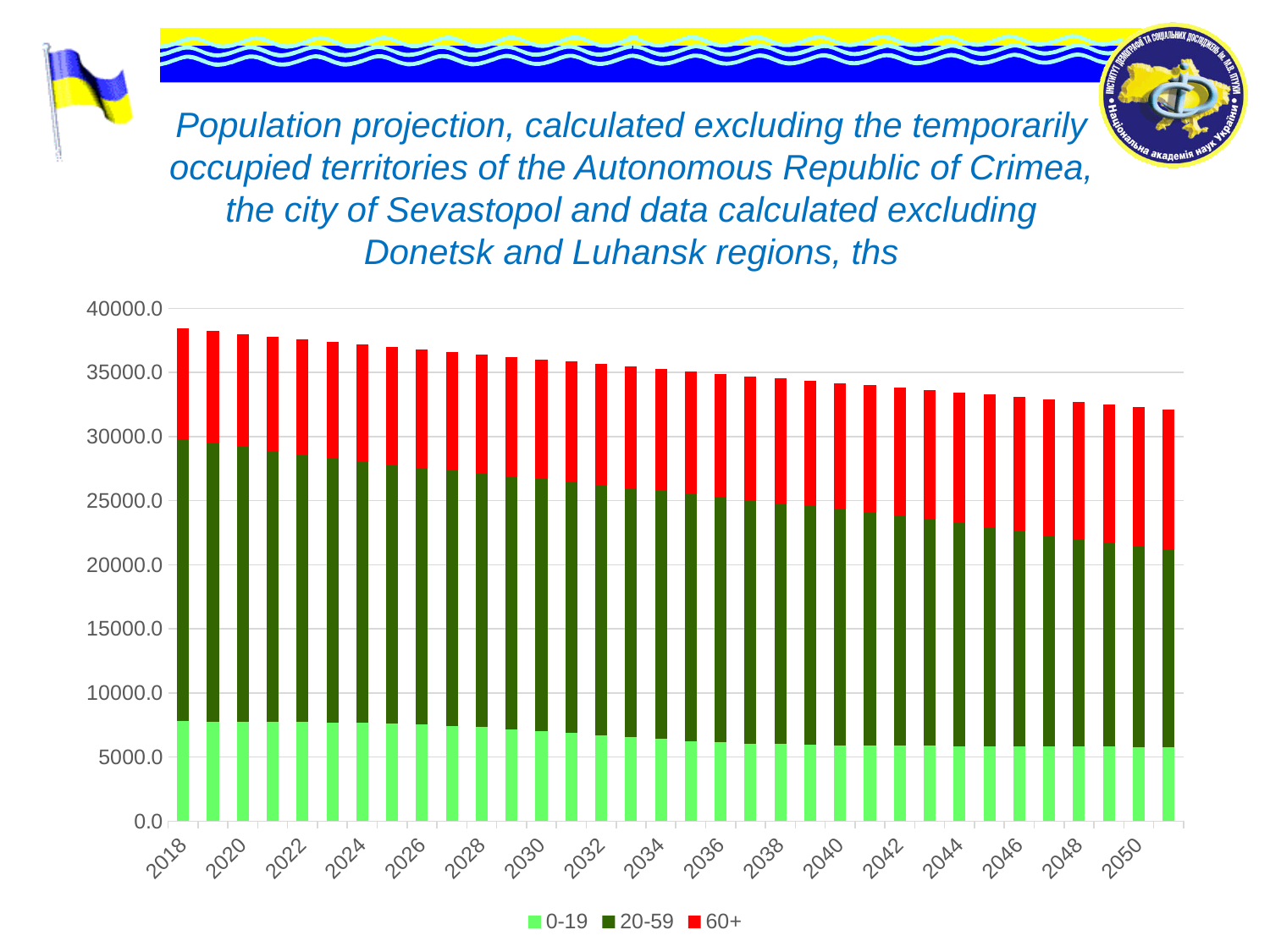
Is the total projected population for 2040 greater or less than 35000.0? less Which year has the highest total projected population? 2018 Is the total projected population for 2018 greater or less than 40000.0? less Which colour represents the 60+ age group? red Is the total projected population for 2050 greater or less than 35000.0? less Which age groups are listed in the legend? 0-19, 20-59, 60+ Does the total projected population rise or fall from 2018 to 2050? fall What kind of chart is shown on the slide? stacked bar chart Which year has the larger total projected population, 2018 or 2050? 2018 How many series does the legend list? 3